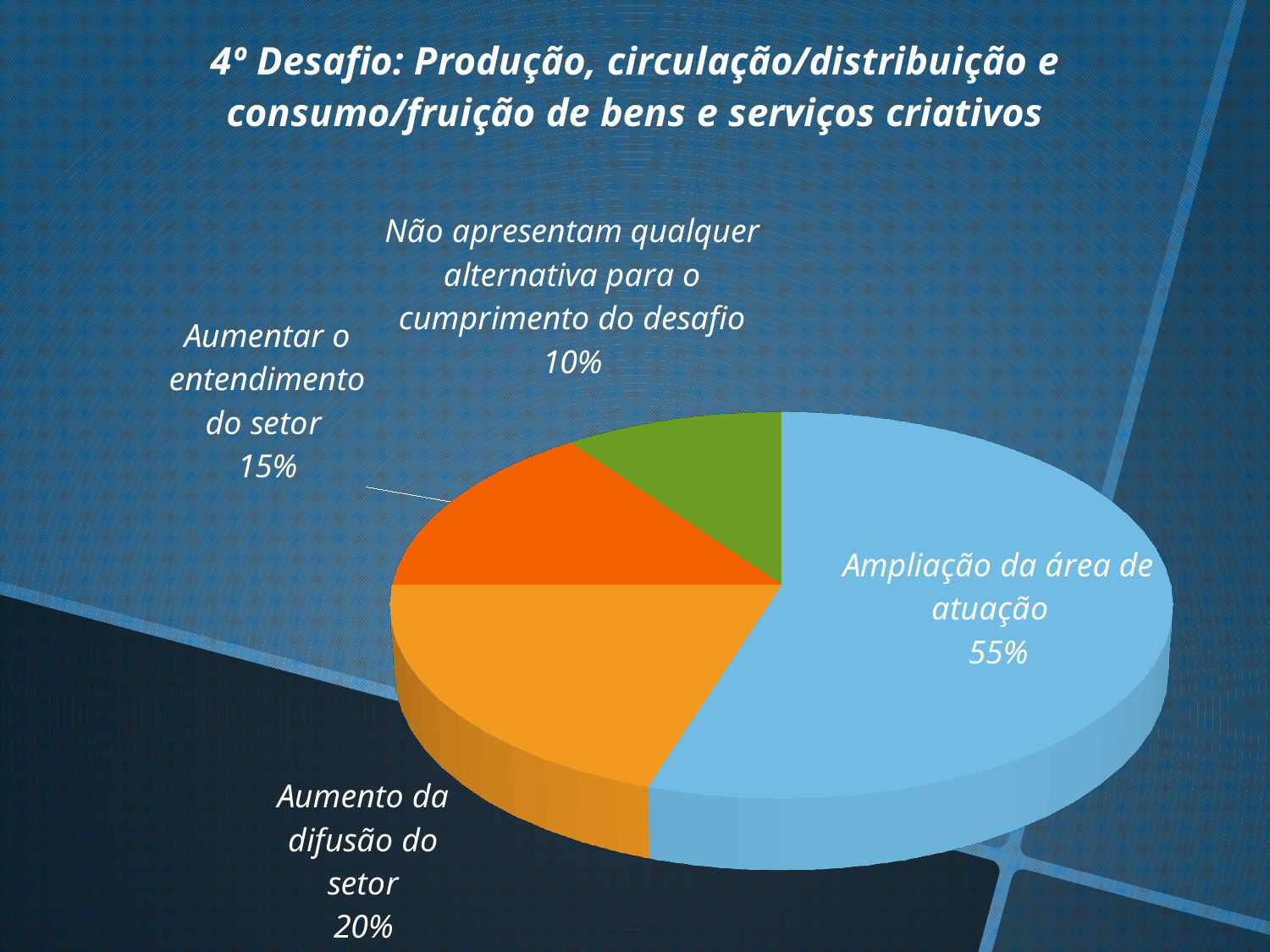
Which slice of the pie is the largest? Ampliação da área de atuação What percentage is shown for 'Não apresentam qualquer alternativa para o cumprimento do desafio'? 10% What colour is the slice for 'Ampliação da área de atuação'? Light blue What is the difference in percentage points between 'Ampliação da área de atuação' and 'Aumento da difusão do setor'? 35 What percentage of the pie is 'Ampliação da área de atuação'? 55% What kind of chart is shown on the slide? Pie chart How many slices does the pie chart have? 4 What percentage is shown for 'Aumento da difusão do setor'? 20% Which slice of the pie is the smallest? Não apresentam qualquer alternativa para o cumprimento do desafio Which is larger: 'Aumentar o entendimento do setor' or 'Aumento da difusão do setor'? Aumento da difusão do setor What percentage is shown for 'Aumentar o entendimento do setor'? 15% What is the title of the slide? 4º Desafio: Produção, circulação/distribuição e consumo/fruição de bens e serviços criativos